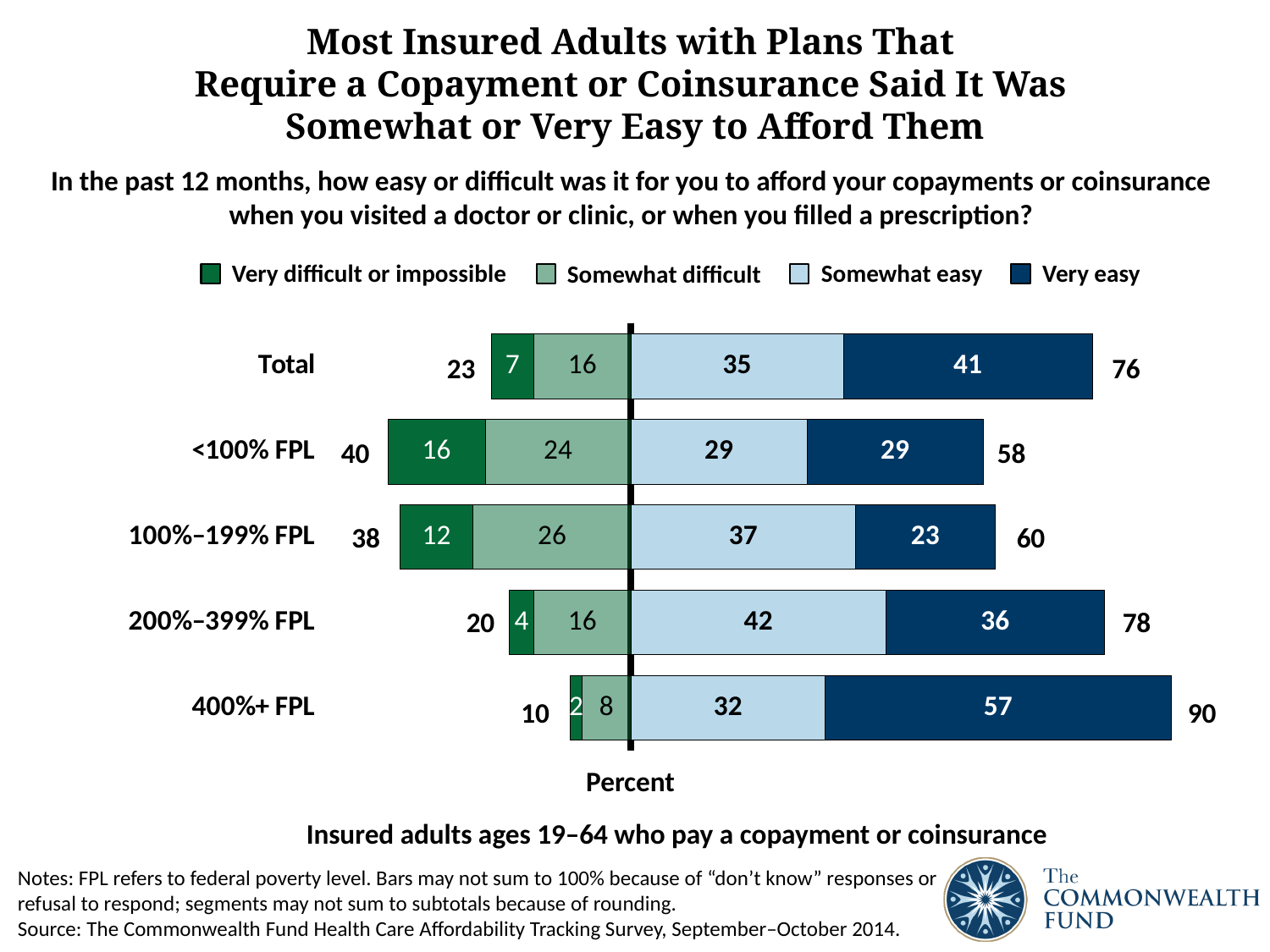
What kind of chart is shown on the slide? Stacked bar chart How many income groups (including Total) are shown in the chart? 5 Which income group has the lowest combined 'difficult' subtotal (shown to the left of the bars)? 400%+ FPL What percentage of adults with incomes of 400%+ FPL said it was very easy to afford their copayments or coinsurance? 57 What is the 'Somewhat easy' value for the 200%–399% FPL group? 42 What is the difference between the 'Very easy' values for the 400%+ FPL group and the 100%–199% FPL group? 34 What percentage of adults with incomes below 100% FPL said it was very difficult or impossible to afford their copayments or coinsurance? 16 Which income group has the highest 'Very easy' value? 400%+ FPL Which legend entry is shown in the darkest blue colour? Very easy What is the combined 'somewhat easy or very easy' subtotal shown for the Total group? 76 How many response categories does the legend list? 4 Which is larger: the 'Somewhat difficult' value for <100% FPL or for 100%–199% FPL? 100%–199% FPL